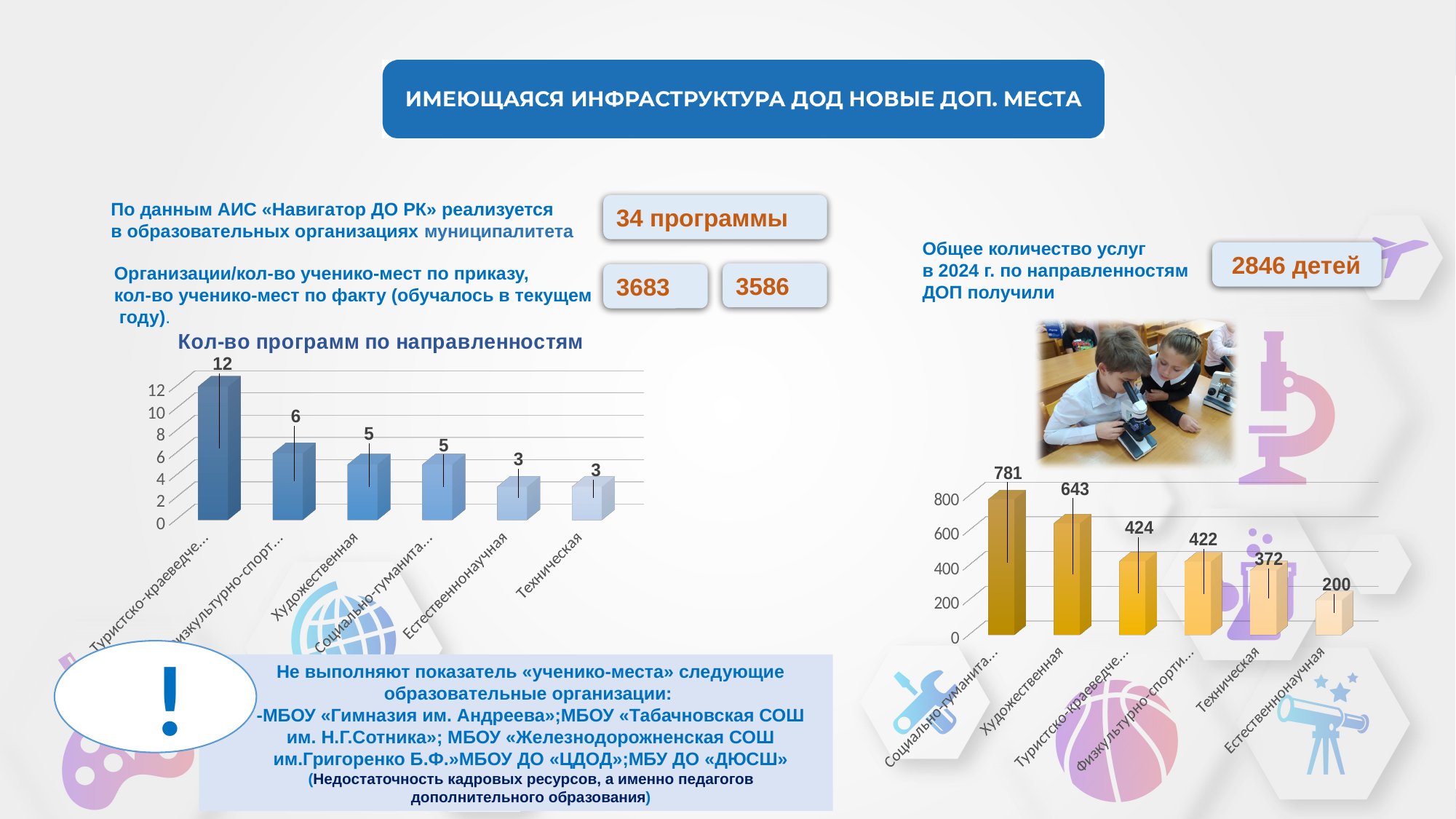
In the chart on the right side of the slide, which category has the lowest value? Естественнонаучная In the chart titled «Кол-во программ по направленностям», what is the value for Техническая? 3 In the chart on the right side of the slide, what is the value for Художественная? 643 In the chart titled «Кол-во программ по направленностям», which category has the highest value? Туристско-краеведческая In the chart on the right side of the slide, what is the value for Техническая? 372 In the chart on the right side of the slide, what is the value for Естественнонаучная? 200 In the chart titled «Кол-во программ по направленностям», how many categories are shown? 6 In the chart on the right side of the slide, which is larger: the value for Художественная or the value for Техническая? Художественная What kind of chart is the chart titled «Кол-во программ по направленностям»? Bar chart In the chart titled «Кол-во программ по направленностям», what is the value for Художественная? 5 In the chart titled «Кол-во программ по направленностям», what is the difference between the first bar (12) and the value for Естественнонаучная? 9 In the chart on the right side of the slide, do the values rise or fall from left to right? Fall